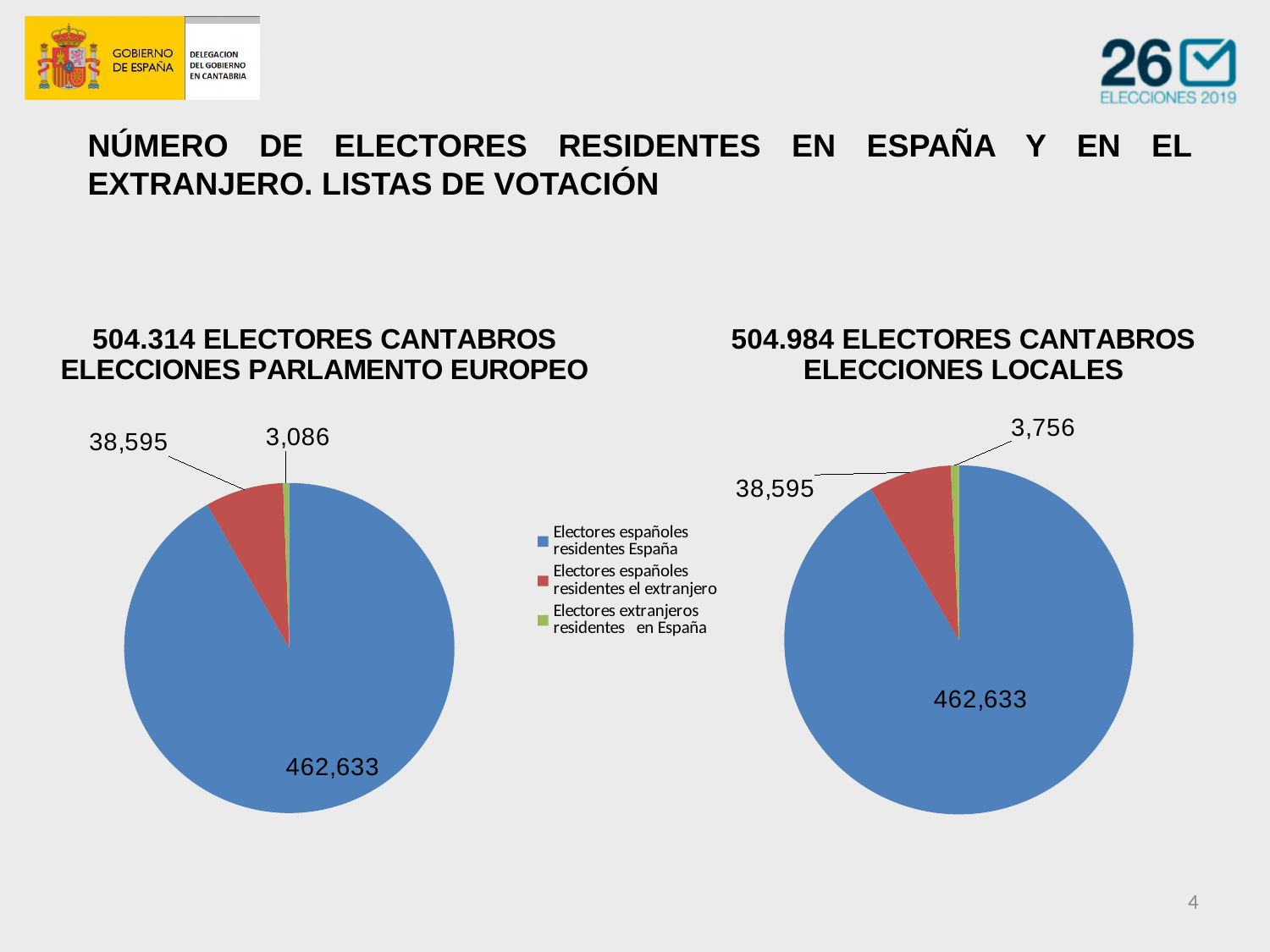
In the chart titled '504.984 ELECTORES CANTABROS ELECCIONES LOCALES', what is the value for Electores españoles residentes el extranjero? 38,595 Which colour represents Electores españoles residentes el extranjero in the pie charts? Red In the chart titled '504.984 ELECTORES CANTABROS ELECCIONES LOCALES', which is larger: Electores españoles residentes el extranjero or Electores extranjeros residentes en España? Electores españoles residentes el extranjero In the chart titled '504.984 ELECTORES CANTABROS ELECCIONES LOCALES', what is the value for Electores extranjeros residentes en España? 3,756 How many categories does the legend list for the pie charts? 3 In the chart titled '504.314 ELECTORES CANTABROS ELECCIONES PARLAMENTO EUROPEO', which category has the largest slice? Electores españoles residentes España In the chart titled '504.984 ELECTORES CANTABROS ELECCIONES LOCALES', which category has the smallest slice? Electores extranjeros residentes en España In the chart titled '504.314 ELECTORES CANTABROS ELECCIONES PARLAMENTO EUROPEO', what is the difference between Electores españoles residentes España and Electores españoles residentes el extranjero? 424,038 In the chart titled '504.314 ELECTORES CANTABROS ELECCIONES PARLAMENTO EUROPEO', what is the value for Electores extranjeros residentes en España? 3,086 In the chart titled '504.314 ELECTORES CANTABROS ELECCIONES PARLAMENTO EUROPEO', what is the value for Electores españoles residentes España? 462,633 What is the difference between the Electores extranjeros residentes en España value in the right-hand chart (ELECCIONES LOCALES) and the same category in the left-hand chart (PARLAMENTO EUROPEO)? 670 What type of chart is used on this slide for the electorate data? Pie chart